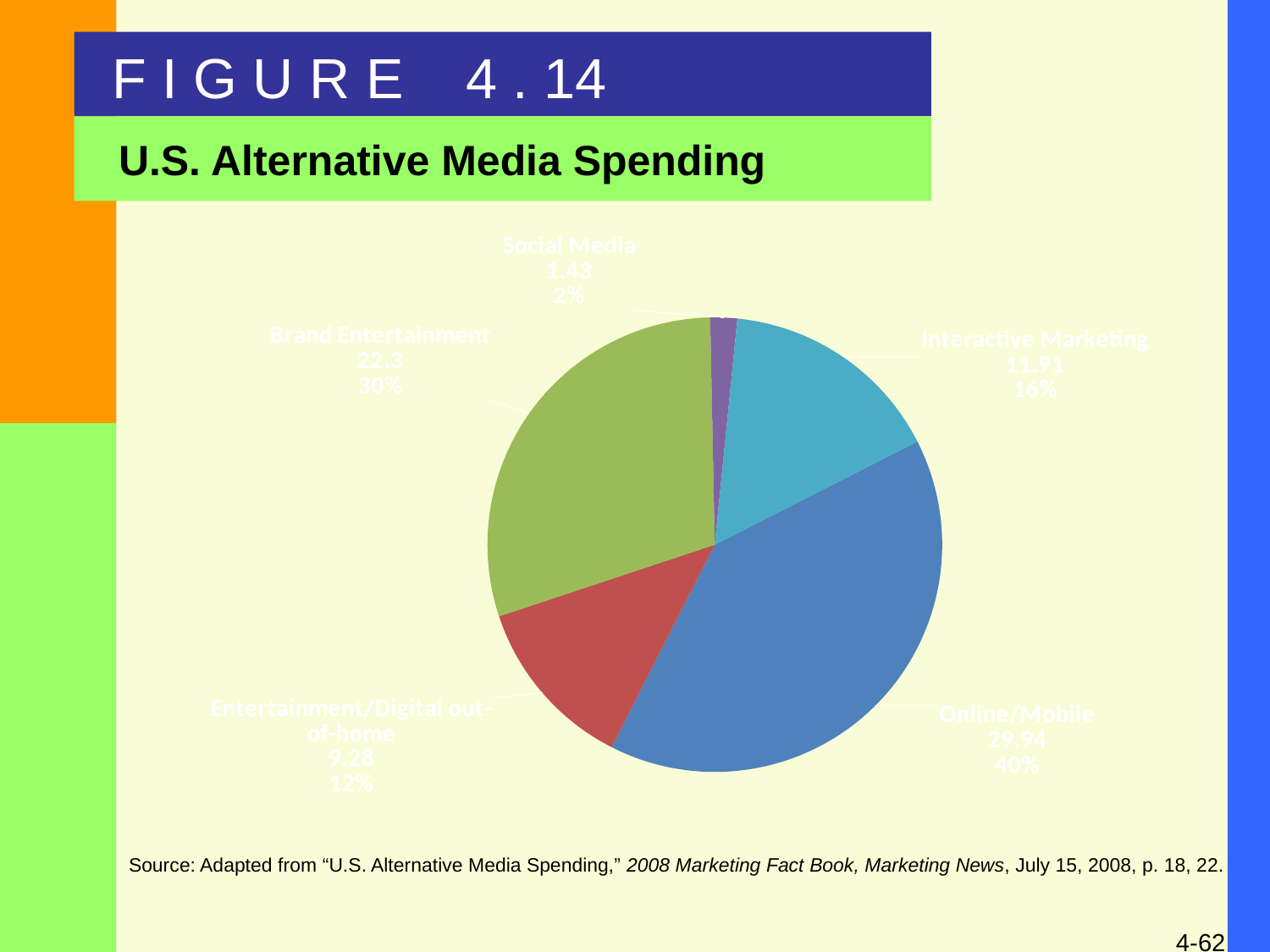
How many slices does the pie chart have? 5 What percentage share does Social Media have? 2% Which is larger, Brand Entertainment or Interactive Marketing? Brand Entertainment What percentage share does Entertainment/Digital out-of-home have? 12% What is the value shown for Online/Mobile? 29.94 What type of chart is shown on the slide? pie chart Which category has the largest slice of the pie? Online/Mobile What percentage share does Brand Entertainment have? 30% Which category has the smallest slice of the pie? Social Media What is the value shown for Interactive Marketing? 11.91 What is the title of the chart on the slide? U.S. Alternative Media Spending What is the difference between the values for Online/Mobile and Brand Entertainment? 7.64